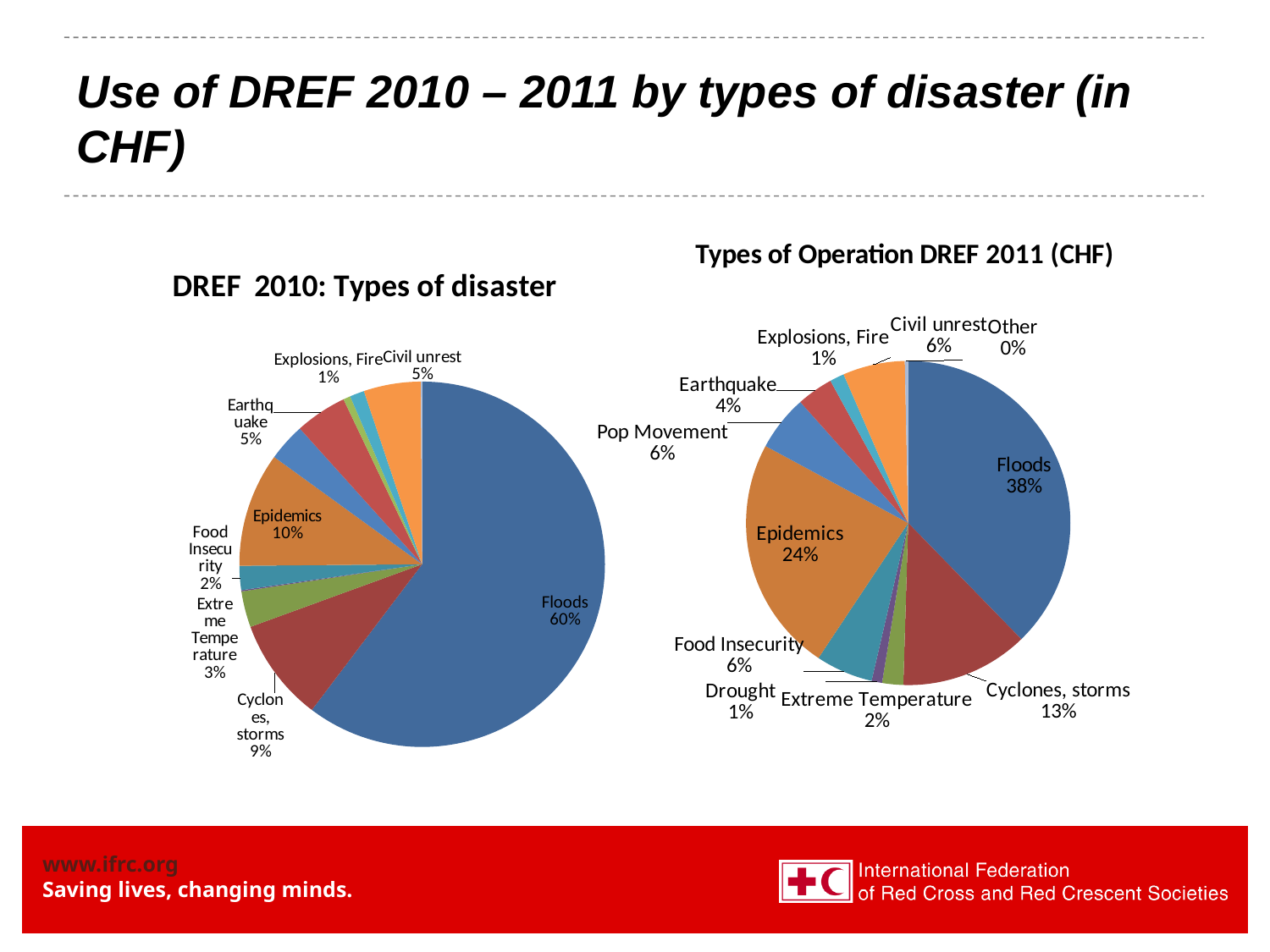
In the Types of Operation DREF 2011 (CHF) chart, how many categories are labelled? 11 In the DREF 2010: Types of disaster chart, which type of disaster has the largest share? Floods In the Types of Operation DREF 2011 (CHF) chart, which category has the smallest share? Other In the Types of Operation DREF 2011 (CHF) chart, what percentage is shown for Cyclones, storms? 13% In the Types of Operation DREF 2011 (CHF) chart, what share do Floods account for? 38% Which is larger: the Epidemics share in the DREF 2010 chart or the Epidemics share in the DREF 2011 chart? DREF 2011 (24%) In the DREF 2010: Types of disaster chart, what percentage is shown for Epidemics? 10% What is the difference in percentage points between the Floods share in the DREF 2010 chart and the Floods share in the DREF 2011 chart? 22 In the DREF 2010: Types of disaster chart, what percentage is shown for Cyclones, storms? 9% In the DREF 2010: Types of disaster chart, what share do Floods account for? 60% In the Types of Operation DREF 2011 (CHF) chart, what percentage is shown for Epidemics? 24% What kind of charts are shown on the slide? Pie charts